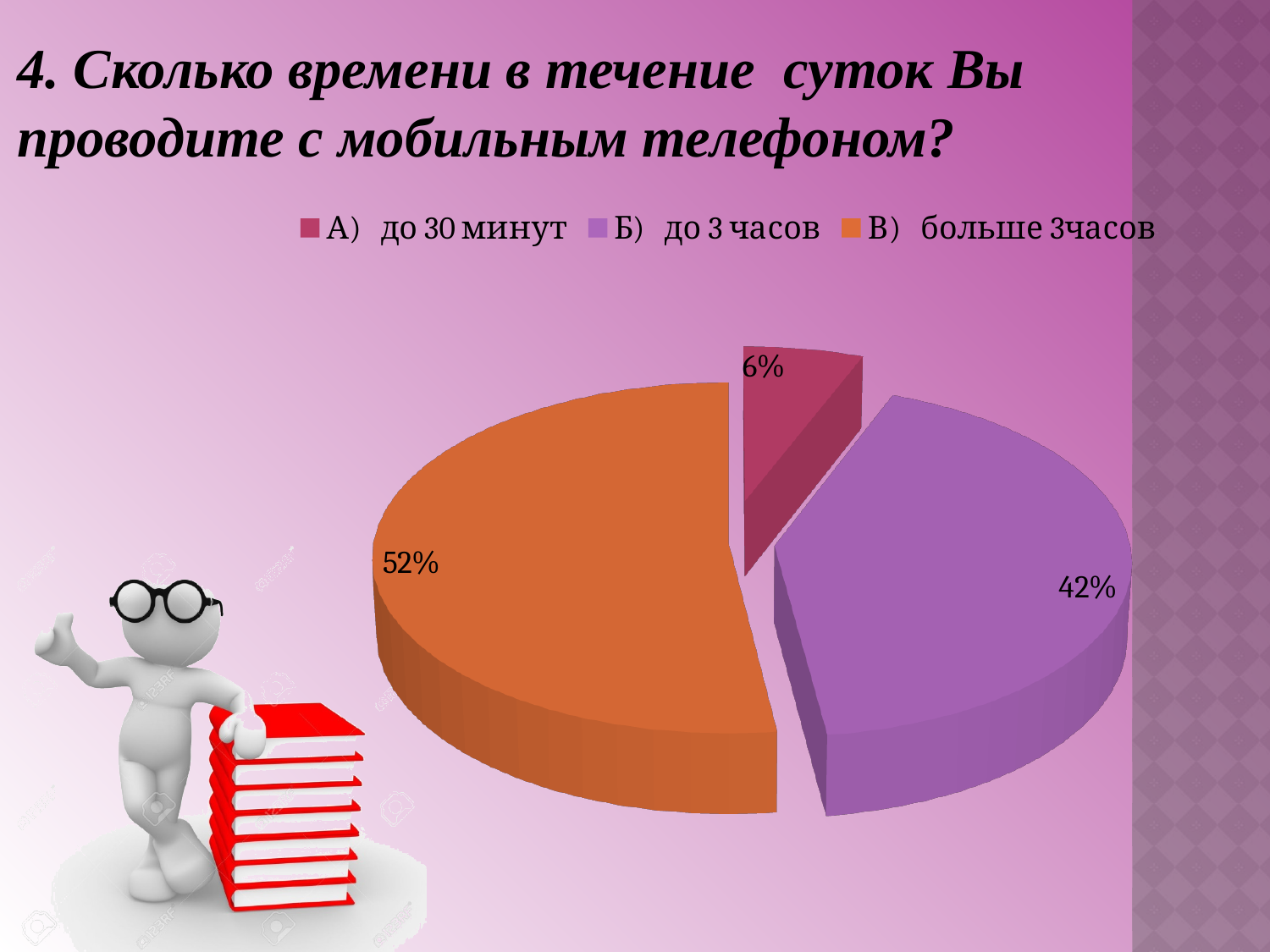
What is the difference between the shares for "Б) до 3 часов" and "А) до 30 минут"? 36% What share of the pie does "В) больше 3часов" have? 52% How many slices does the pie chart have? 3 What colour is the slice for "В) больше 3часов"? orange What share of the pie does "Б) до 3 часов" have? 42% What kind of chart is shown on the slide? pie chart What share of the pie does "А) до 30 минут" have? 6% Which is larger, the share for "Б) до 3 часов" or the share for "А) до 30 минут"? Б) до 3 часов Which category has the largest slice of the pie? В) больше 3часов Which category has the smallest slice of the pie? А) до 30 минут What is the difference between the shares for "В) больше 3часов" and "Б) до 3 часов"? 10% What colour is the slice for "Б) до 3 часов"? purple